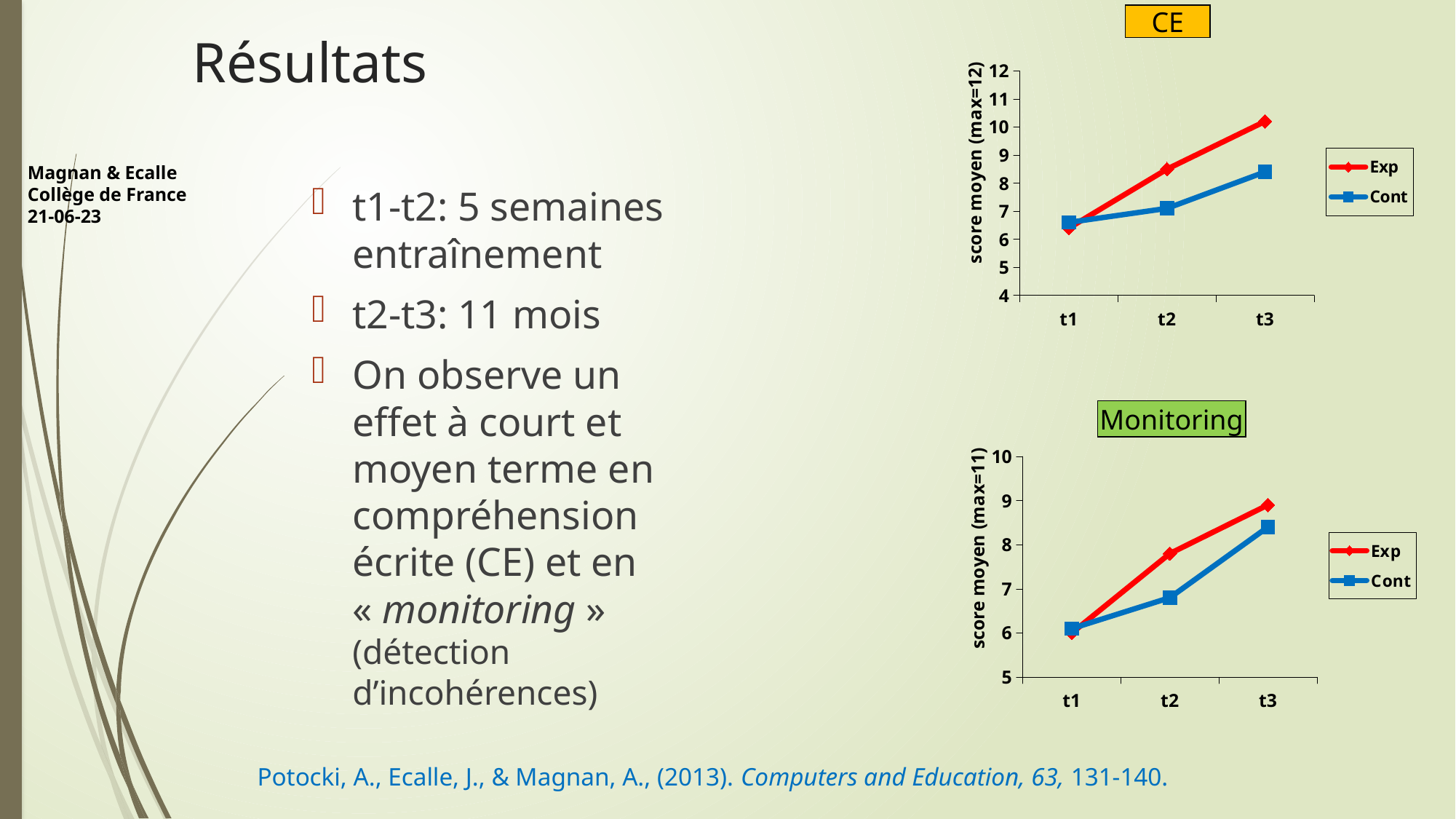
In the Monitoring chart, is the value for Exp at t3 greater or less than 8? greater In the CE chart, is the value for Exp at t3 greater or less than 9? greater In the Monitoring chart, what are the two series named in the legend? Exp and Cont In the CE chart, at which time point does the Exp series reach its highest value? t3 In the CE chart, which series has the higher value at t2, Exp or Cont? Exp In the CE chart, how many time points are shown on the x axis? 3 In the Monitoring chart, which series has the higher value at t2, Exp or Cont? Exp In the CE chart, how many series does the legend list? 2 In the CE chart, is the value for Cont at t3 greater or less than 9? less In the Monitoring chart, what kind of chart is shown? line chart In the CE chart, what kind of chart is shown? line chart In the CE chart, does the Exp series rise or fall from t1 to t3? rise